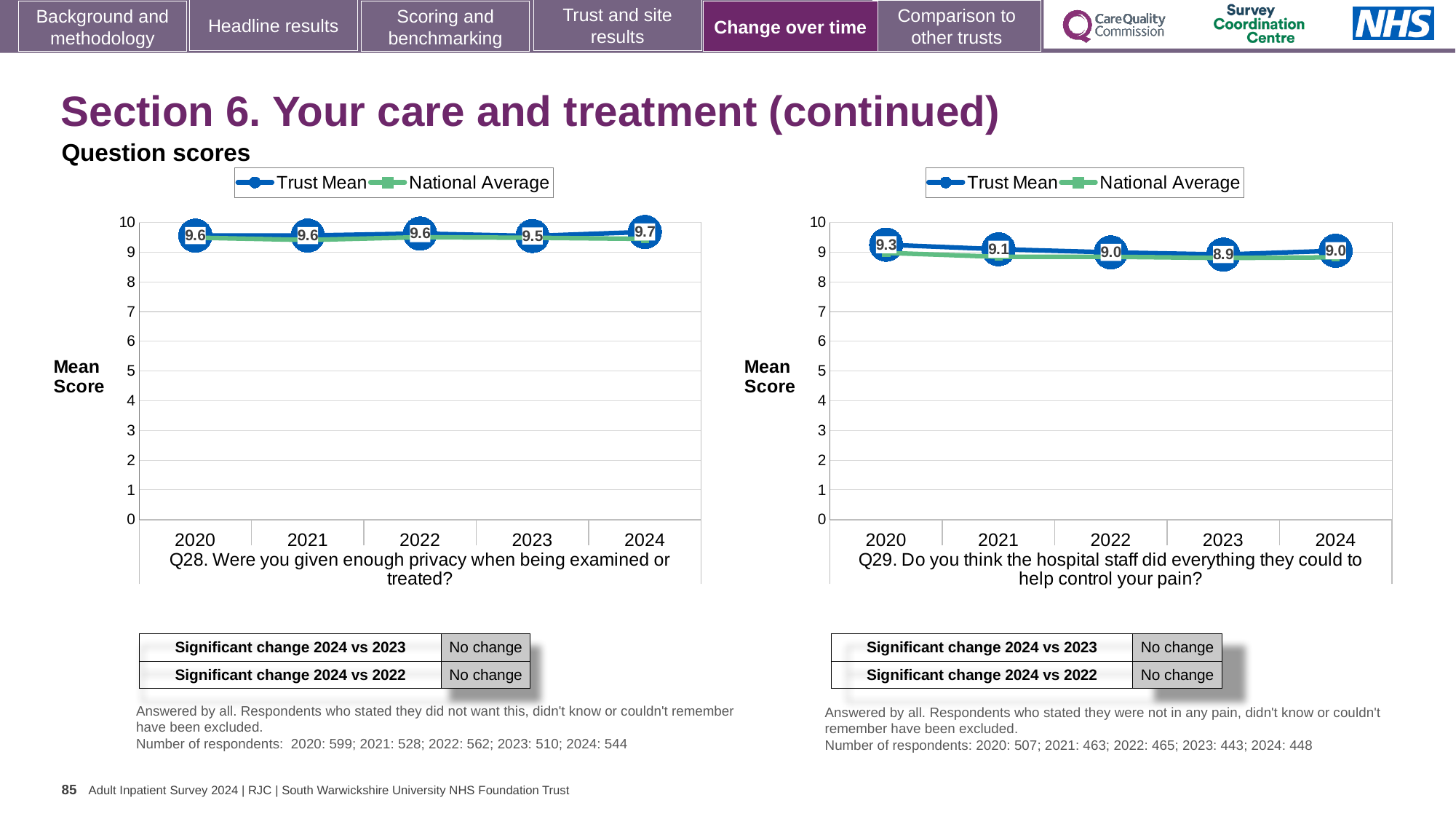
On the Q29 chart (right), does the Trust Mean rise or fall from 2020 to 2023? Fall On the Q28 chart (left), which year has the highest Trust Mean score? 2024 How many years are plotted on the Q28 chart (left)? 5 On the Q29 chart (right), what is the difference between the Trust Mean scores for 2020 and 2023? 0.4 On the Q28 chart (left), what is the Trust Mean score for 2024? 9.7 On the Q29 chart (right), what is the Trust Mean score for 2020? 9.3 On the Q29 chart (right), is the National Average for 2023 greater or less than 8? greater How many series does the legend of the Q29 chart (right) list? 2 On the Q29 chart (right), which year has the lowest Trust Mean score? 2023 On the Q28 chart (left), which is larger, the Trust Mean for 2023 or for 2024? 2024 On the Q28 chart (left), what is the Trust Mean score for 2023? 9.5 What kind of chart is the Q28 chart (left)? Line chart